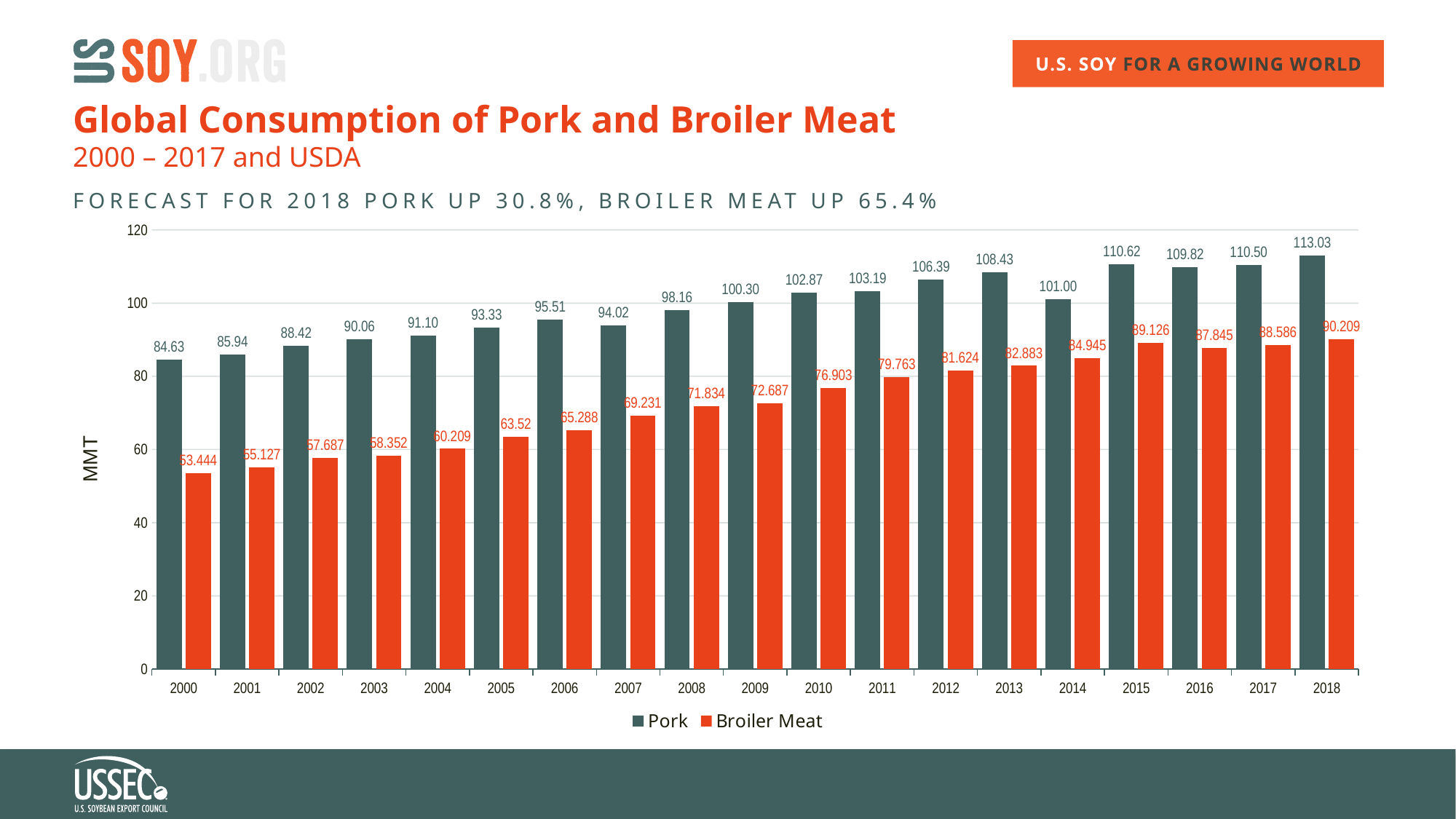
Which year has the lowest Broiler Meat value? 2000 How many years are shown on the x axis? 19 Which year has the highest Pork value? 2018 Is the Broiler Meat value for 2009 greater or less than 80? less What is the Broiler Meat value for 2018? 90.209 What is the Broiler Meat value for 2005? 63.52 Which is larger, the Pork value for 2013 or the Pork value for 2014? 2013 How many series does the legend list? 2 What is the label on the y axis? MMT What is the difference between the Pork values for 2018 and 2000? 28.40 What kind of chart is shown? bar chart What is the Pork value for 2010? 102.87